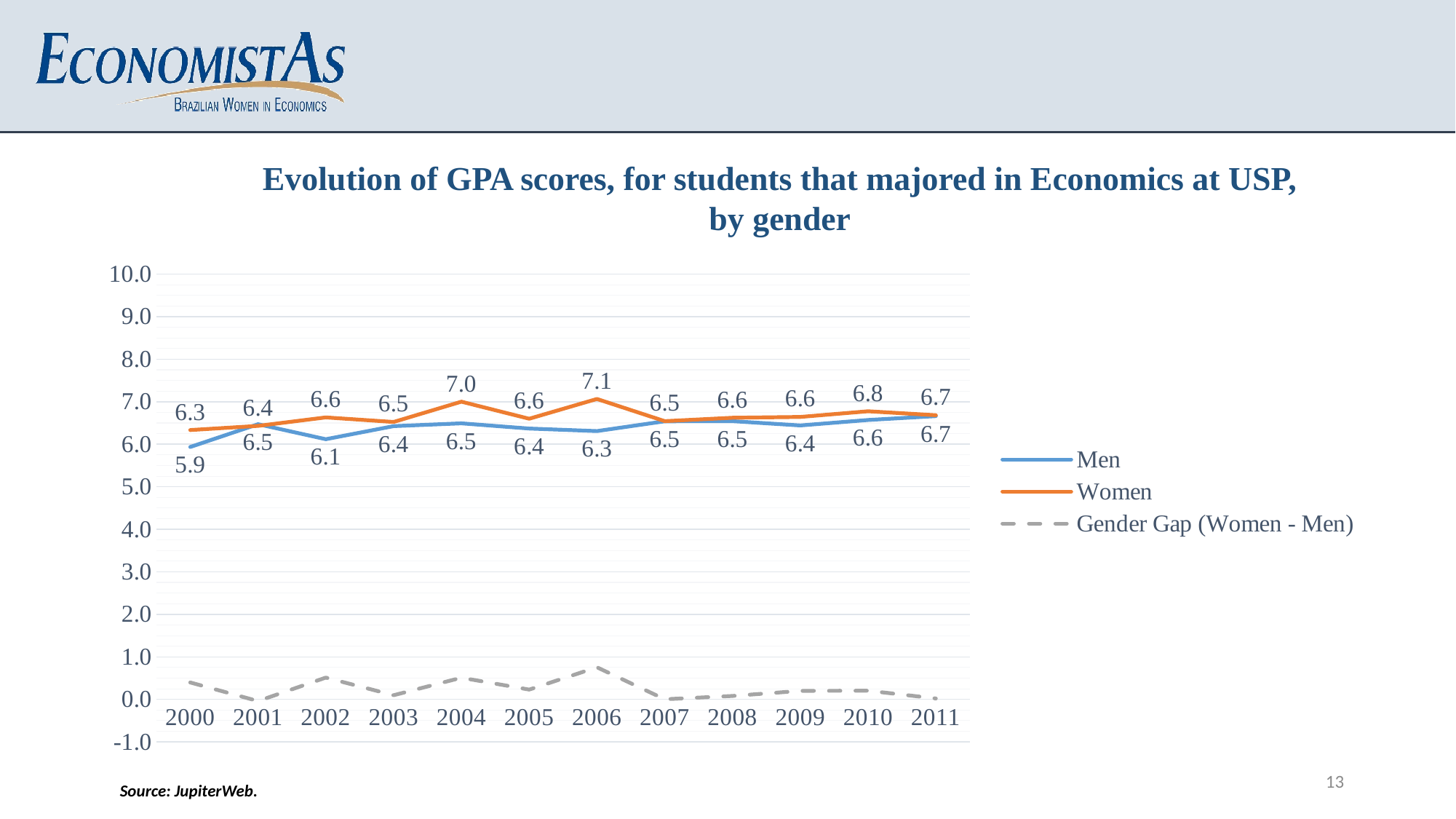
How many series does the legend list? 3 What kind of chart is shown on the slide? Line chart In which year did Women have their highest GPA score? 2006 Which series is drawn with a dashed line? Gender Gap (Women - Men) In which year did Men have their lowest GPA score? 2000 How many years are plotted on the x axis? 12 What was the GPA score for Men in 2011? 6.7 Is the Gender Gap (Women - Men) value in 2006 greater or less than 1.0? less What was the GPA score for Men in 2000? 5.9 What was the GPA score for Women in 2004? 7.0 In 2002, which group had the higher GPA score, Men or Women? Women What is the difference between the Women and Men GPA scores in 2006? 0.8